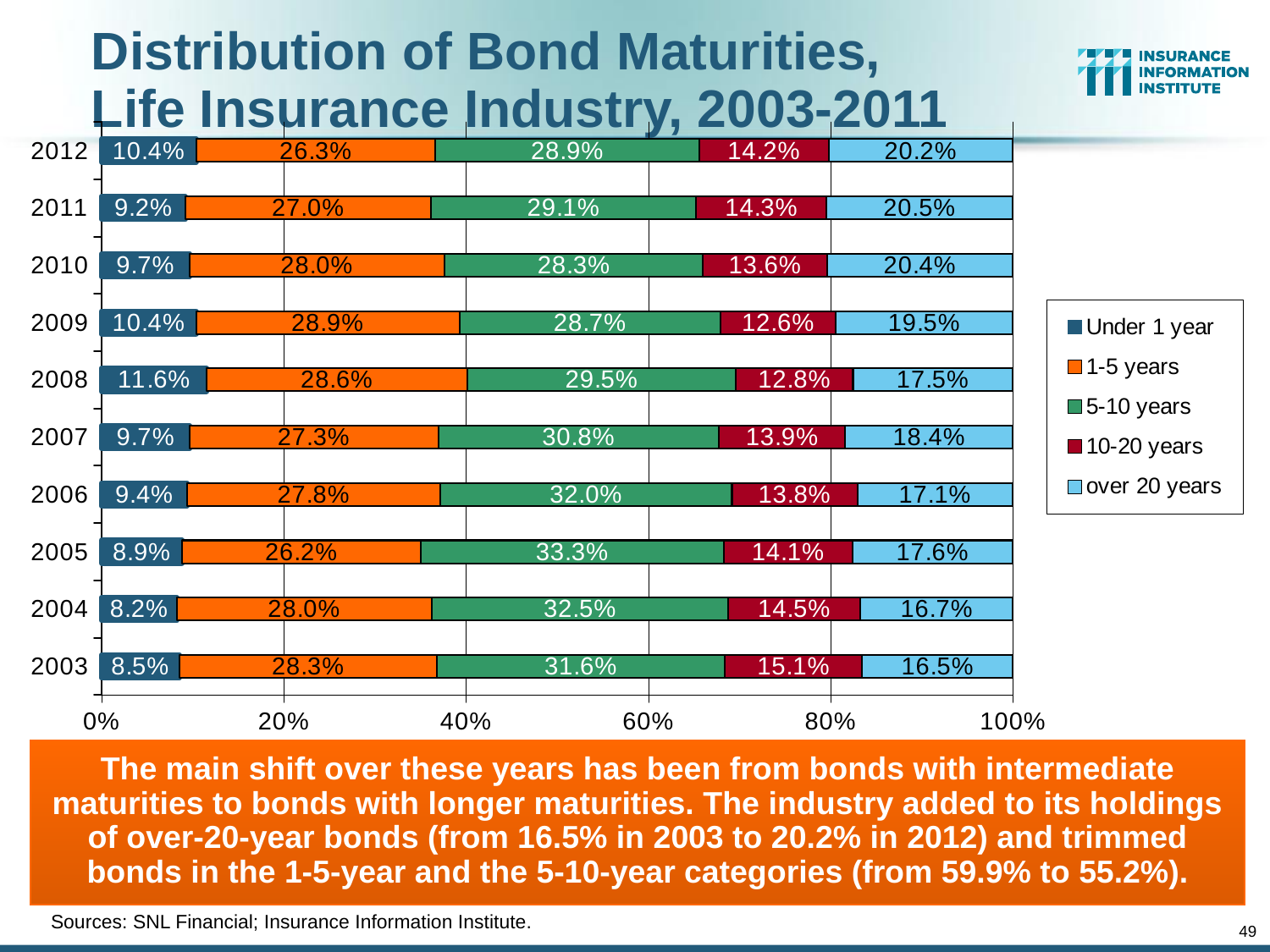
What is the difference between the 'over 20 years' value in 2012 and in 2003? 3.7 percentage points How many series does the legend list? 5 What share of bonds was 'Under 1 year' in 2008? 11.6% Does the 'over 20 years' share generally rise or fall from 2003 to 2012? Rise Which is larger: the '1-5 years' value in 2011 or in 2012? 2011 What is the value for 'over 20 years' in 2012? 20.2% What is the value for '5-10 years' in 2005? 33.3% Which year has the highest value for '5-10 years'? 2005 How many years are shown on the chart? 10 Which year has the lowest value for 'over 20 years'? 2003 What kind of chart is shown on the slide? Stacked bar chart What is the total of the stacked bar for 2012? 100.0%